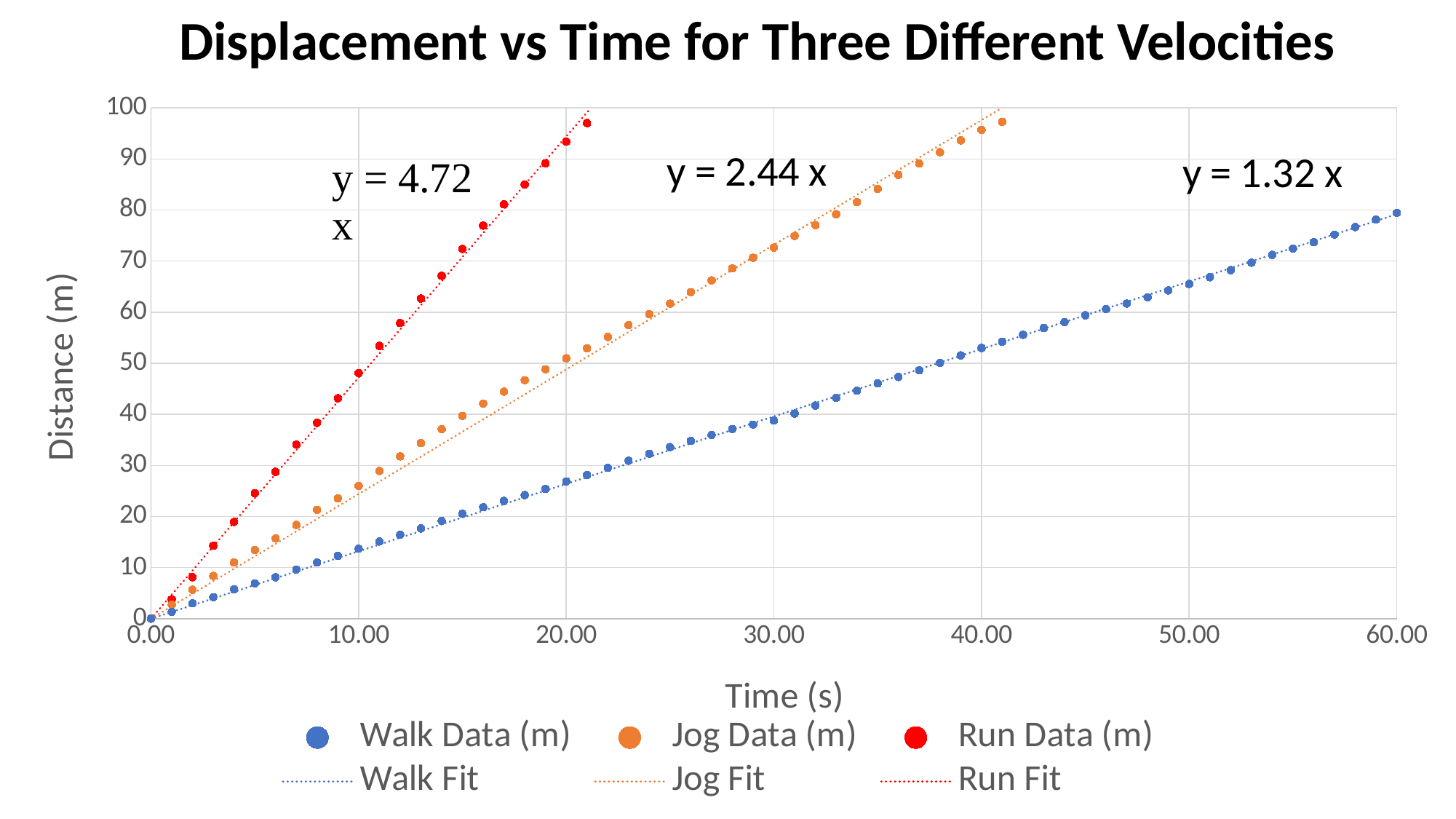
Do the distance values rise or fall as time increases? rise What is the slope of the Walk Fit line according to the printed equation? 1.32 Which series has the steepest fit line? Run Data (m) What is the title of the chart? Displacement vs Time for Three Different Velocities What kind of chart is shown on the slide? scatter chart At 20.00 s, which is higher: the Jog Data or the Walk Data? Jog Data Is the Jog Data distance at 40.00 s greater or less than 90? greater Is the Walk Data distance at 60.00 s greater or less than 70? greater Which series has the shallowest fit line? Walk Data (m) How many entries does the chart legend list? 6 What is the fit equation printed for the Jog data? y = 2.44 x What is the fit equation printed for the Run data? y = 4.72 x